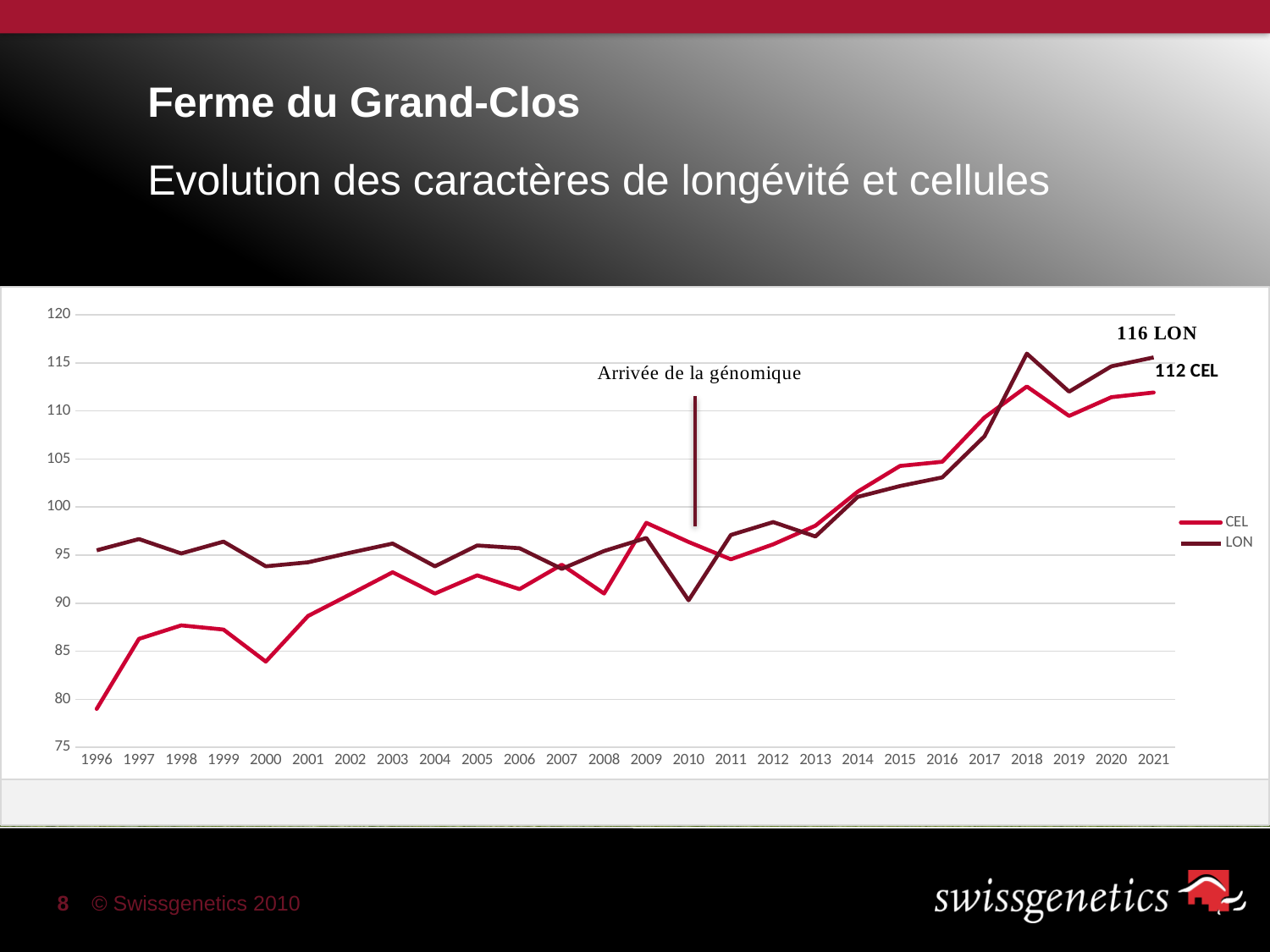
What kind of chart is shown on the slide? line chart How many series does the legend list? 2 In 2021, which series has the higher value, CEL or LON? LON How many years are shown on the x axis? 26 In 2010, which series has the higher value, CEL or LON? CEL What is the difference between LON and CEL in 2021? 4 Is the value for LON in 2010 greater or less than 95? less What is the value of LON in 2021? 116 What is the value of CEL in 2021? 112 In which year is the CEL series at its lowest? 1996 Is the value for CEL in 1997 greater or less than 90? less What does the annotation above the vertical line at 2010 say? Arrivée de la génomique